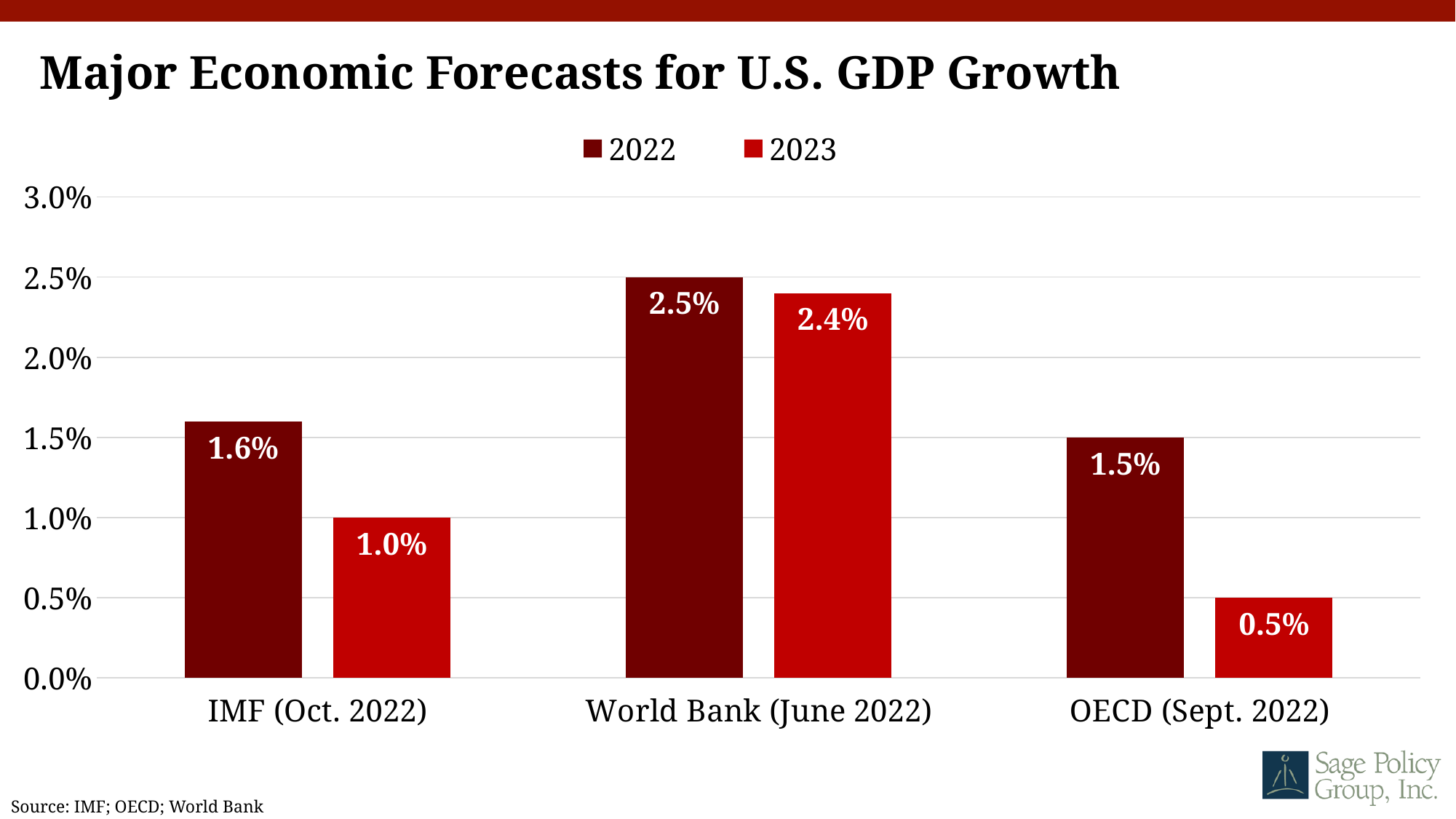
Is the World Bank's 2022 forecast greater or less than 2.0%? greater Which forecaster has the lowest 2023 GDP growth forecast? OECD (Sept. 2022) Which is larger, the IMF's 2023 forecast or the OECD's 2023 forecast? IMF's 2023 forecast How many forecasters are shown on the x axis? 3 What is the difference between the IMF's 2022 and 2023 forecasts? 0.6% What kind of chart is shown on the slide? Bar chart What is the 2023 GDP growth forecast from the World Bank (June 2022)? 2.4% What is the 2023 GDP growth forecast from the OECD (Sept. 2022)? 0.5% What is the 2022 GDP growth forecast from the IMF (Oct. 2022)? 1.6% Which forecaster has the highest 2022 GDP growth forecast? World Bank (June 2022) What is the difference between the OECD's 2022 and 2023 forecasts? 1.0% How many series does the legend list? 2